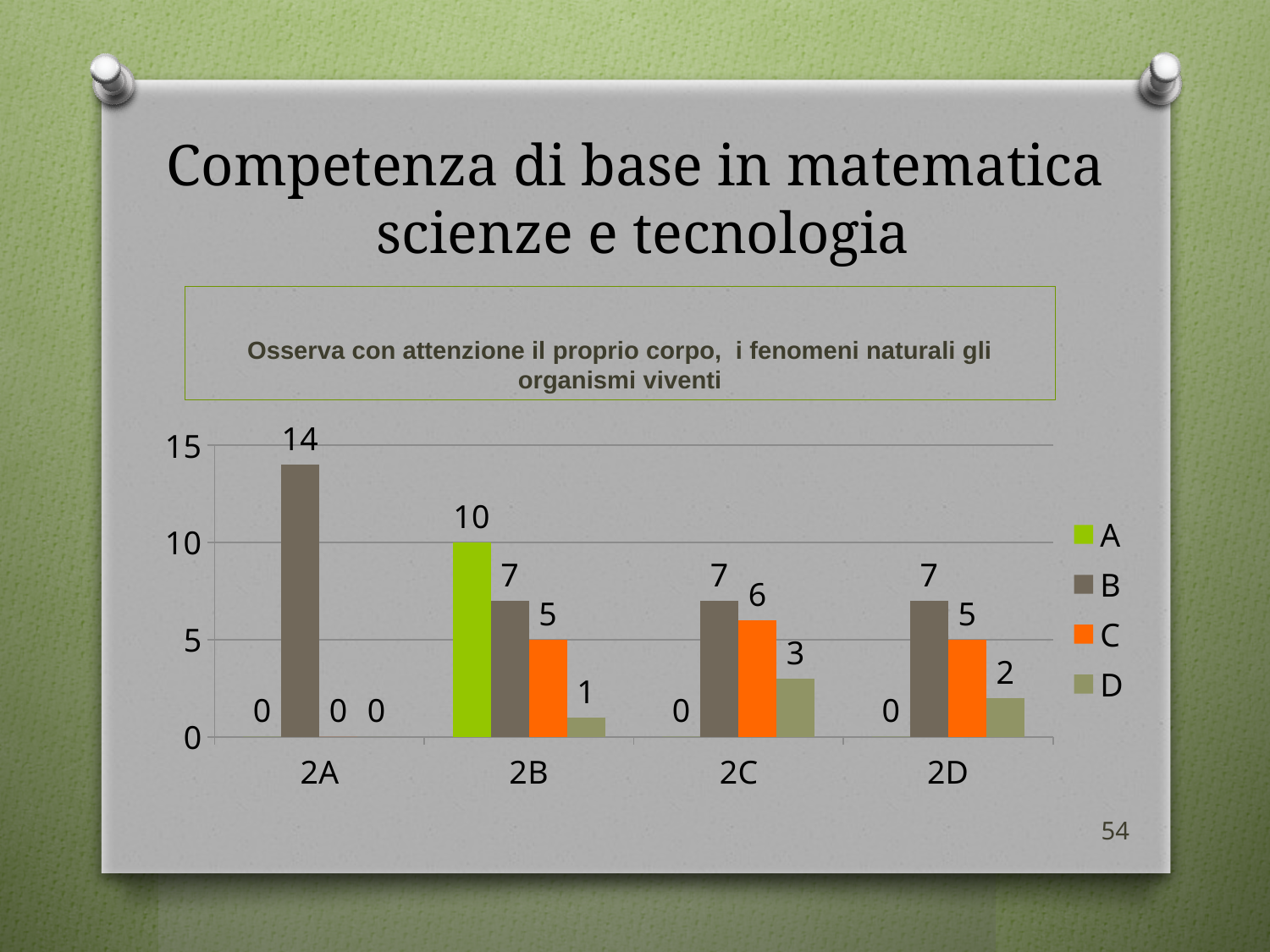
How many series does the legend list? 4 What is the value for series D in category 2D? 2 Which is larger: the value for series C in 2C or the value for series C in 2D? 2C What is the value for series A in category 2B? 10 What kind of chart is shown on the slide? bar chart Which category has the lowest value for series D? 2A What is the difference between the value for series B in 2A and the value for series B in 2B? 7 Which category has the highest value for series B? 2A What is the title of the chart? Osserva con attenzione il proprio corpo, i fenomeni naturali gli organismi viventi What is the value for series C in category 2C? 6 How many categories are shown on the x axis? 4 What is the value for series B in category 2A? 14